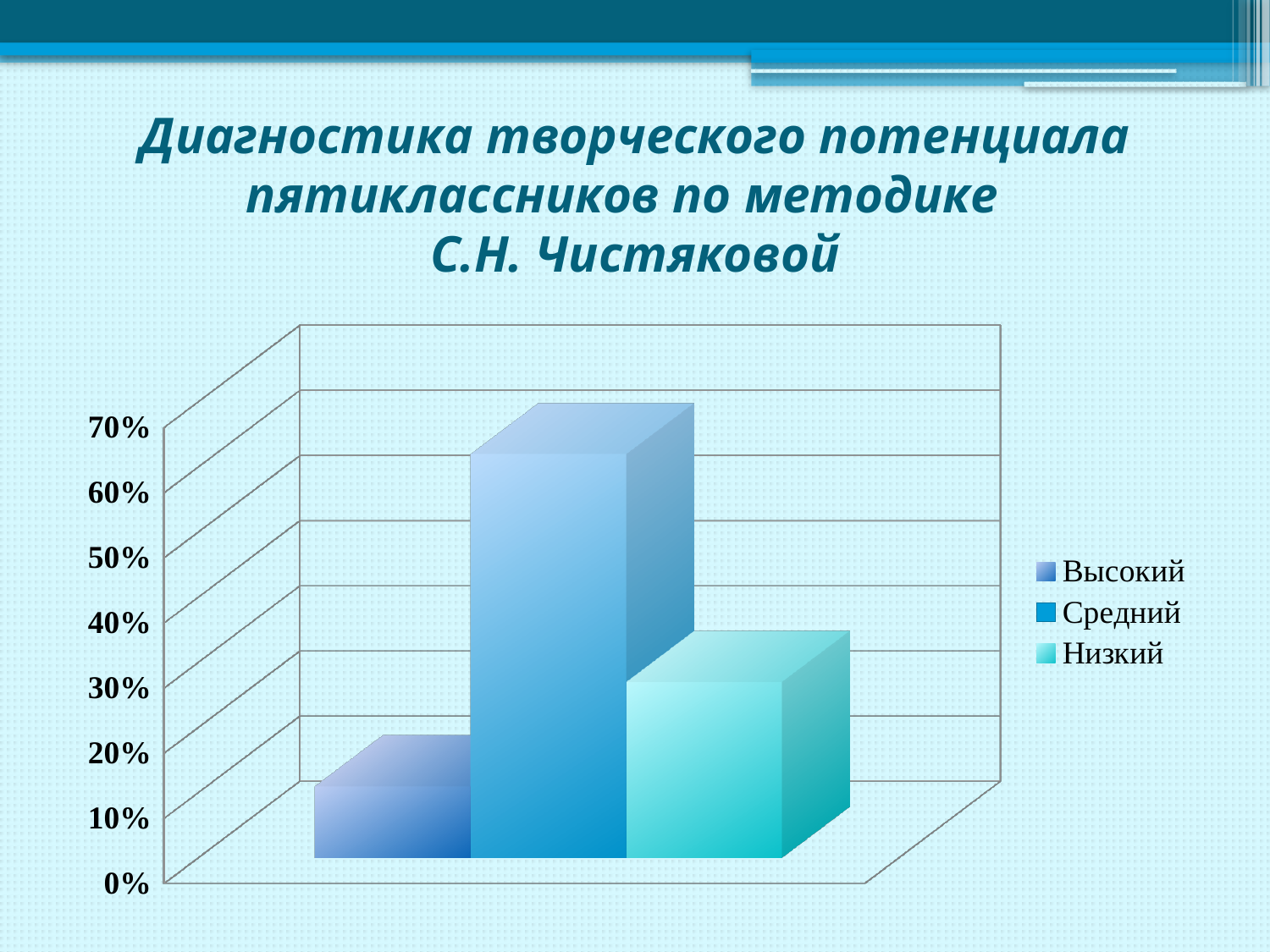
Which is larger, the value for Средний or the value for Низкий? Средний Is the value for Средний greater or less than 50%? greater Which is larger, the value for Низкий or the value for Высокий? Низкий Which category has the highest bar? Средний What kind of chart is shown on the slide? bar chart How many entries does the legend list? 3 Is the value for Низкий greater or less than 20%? greater Is the value for Высокий greater or less than 20%? less How many bars are plotted in the chart? 3 What is the highest value shown on the vertical axis? 70% Which category has the lowest bar? Высокий